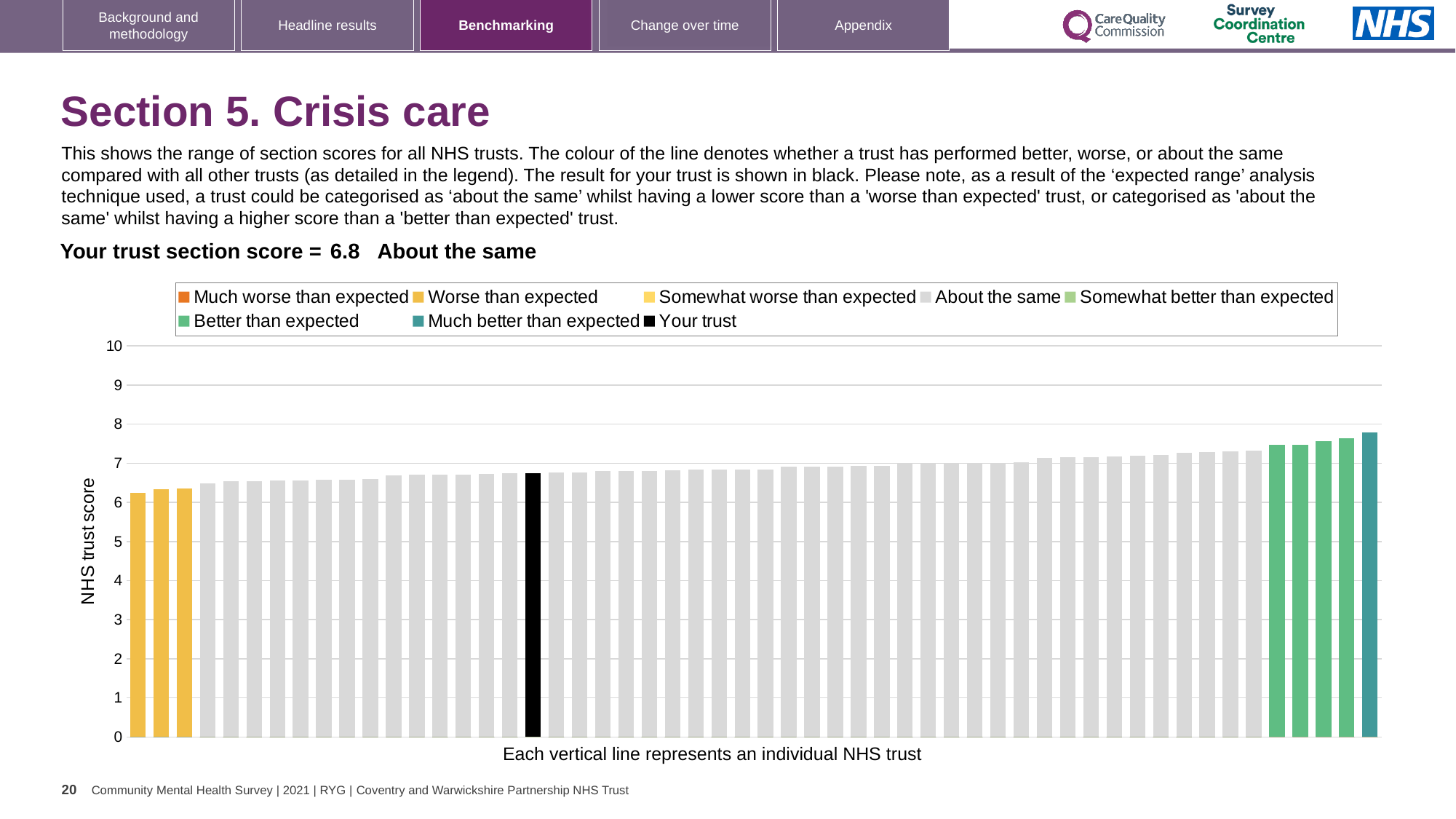
Is the value of the leftmost bar greater or less than 7? less How is your trust categorised relative to other trusts on this slide? About the same Is the value for your trust (the black bar) greater or less than 6? greater What colour is used for the bar representing your trust? black Do the bar values rise or fall from left to right along the x axis? rise Is the value of the rightmost bar greater or less than 7? greater How many entries does the chart legend list? 8 Which is larger: the rightmost bar or the leftmost bar? the rightmost bar What is the label on the vertical axis of the chart? NHS trust score What kind of chart is shown on the slide? bar chart What is the section score for your trust shown on the slide? 6.8 Which is larger: your trust's bar or the leftmost bar? your trust's bar